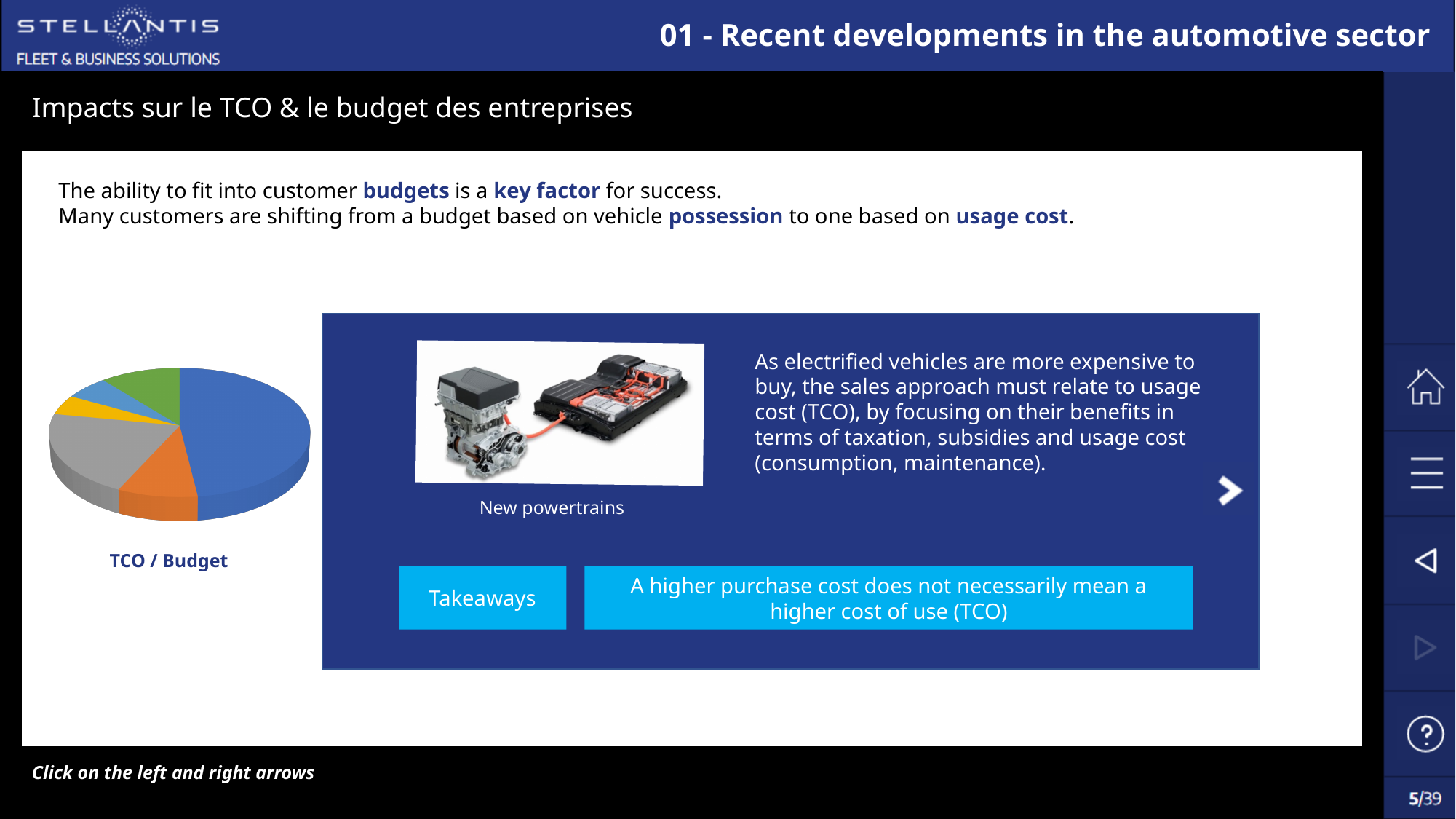
Which colour slice is the largest in the pie chart? Blue Does the pie chart display a legend? No In the pie chart, which slice is larger, the orange one or the yellow one? Orange In the pie chart, which slice is larger, the gray one or the light blue one? Gray What is the title shown under the pie chart? TCO / Budget How many slices does the pie chart have? 6 What kind of chart is shown on the left of the slide? Pie chart In the pie chart, which slice is larger, the blue one or the green one? Blue